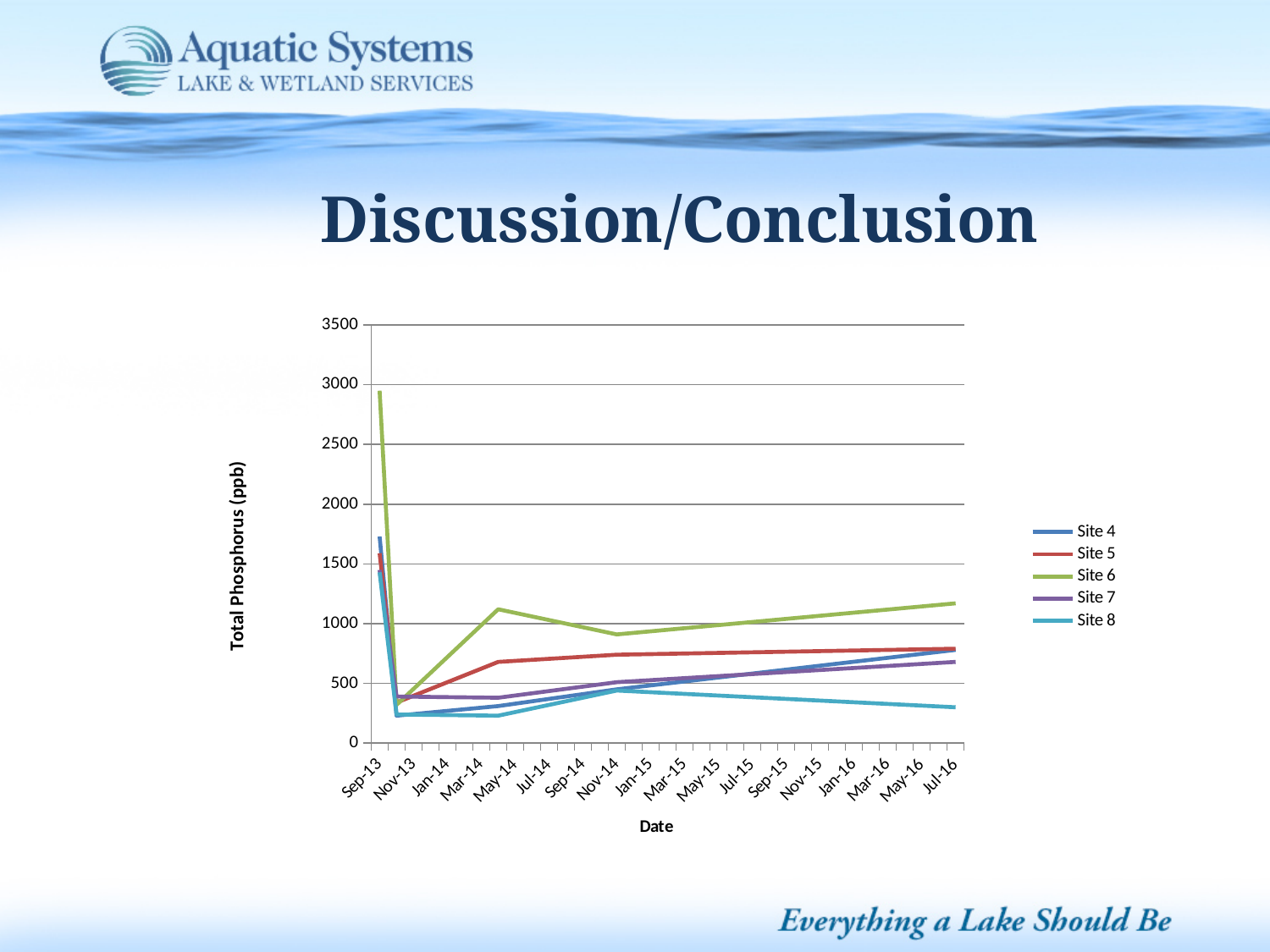
Which site has the highest value at Sep-13? Site 6 What is the x-axis title of the chart? Date Is the value for Site 6 at Jul-16 greater or less than 1000? greater Which site has the highest value at Jul-16? Site 6 How many series does the legend list? 5 Which is larger at May-14, the value for Site 5 or the value for Site 7? Site 5 Which site has the lowest value at Jul-16? Site 8 Is the value for Site 8 at Jul-16 greater or less than 500? less Does the value for Site 8 rise or fall from Nov-14 to Jul-16? fall Is the value for Site 6 at Sep-13 greater or less than 2500? greater What kind of chart is shown on the slide? line chart What is the y-axis title of the chart? Total Phosphorus (ppb)